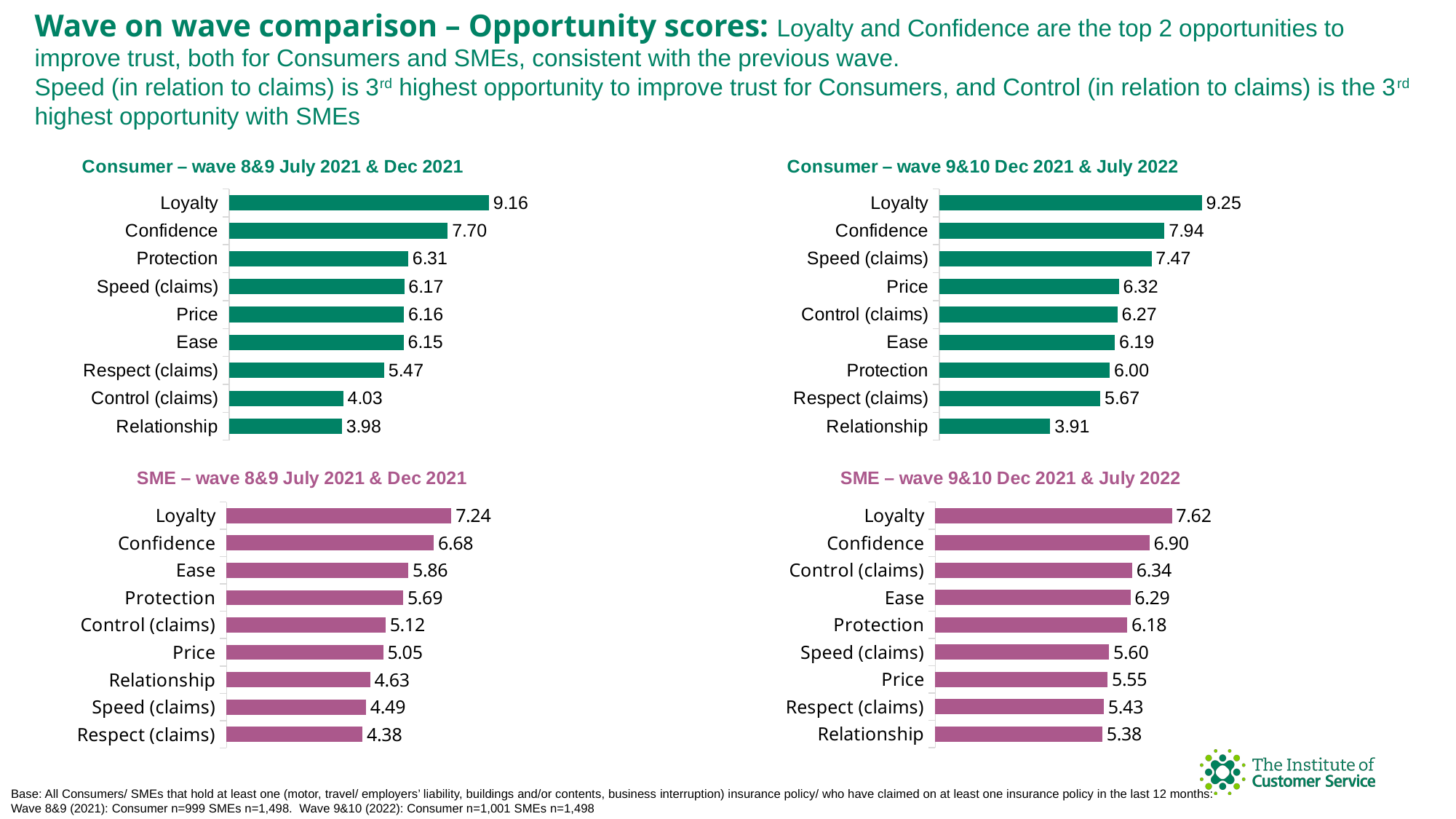
What type of chart is the 'SME – wave 9&10 Dec 2021 & July 2022' chart? Bar chart In the 'Consumer – wave 9&10 Dec 2021 & July 2022' chart, what is the value for Speed (claims)? 7.47 How many charts are shown on the slide? 4 In the 'SME – wave 9&10 Dec 2021 & July 2022' chart, which category has the highest value? Loyalty In the 'SME – wave 8&9 July 2021 & Dec 2021' chart, which category has the lowest value? Respect (claims) In the 'SME – wave 9&10 Dec 2021 & July 2022' chart, what is the difference between the values for Control (claims) and Price? 0.79 In the 'Consumer – wave 8&9 July 2021 & Dec 2021' chart, what is the difference between the values for Loyalty and Confidence? 1.46 In the 'Consumer – wave 8&9 July 2021 & Dec 2021' chart, what is the value for Protection? 6.31 In the 'SME – wave 8&9 July 2021 & Dec 2021' chart, what is the value for Relationship? 4.63 How many categories are shown in the 'Consumer – wave 9&10 Dec 2021 & July 2022' chart? 9 In the 'Consumer – wave 9&10 Dec 2021 & July 2022' chart, which category has the lowest value? Relationship In the 'SME – wave 8&9 July 2021 & Dec 2021' chart, which is larger: the value for Ease or the value for Control (claims)? Ease